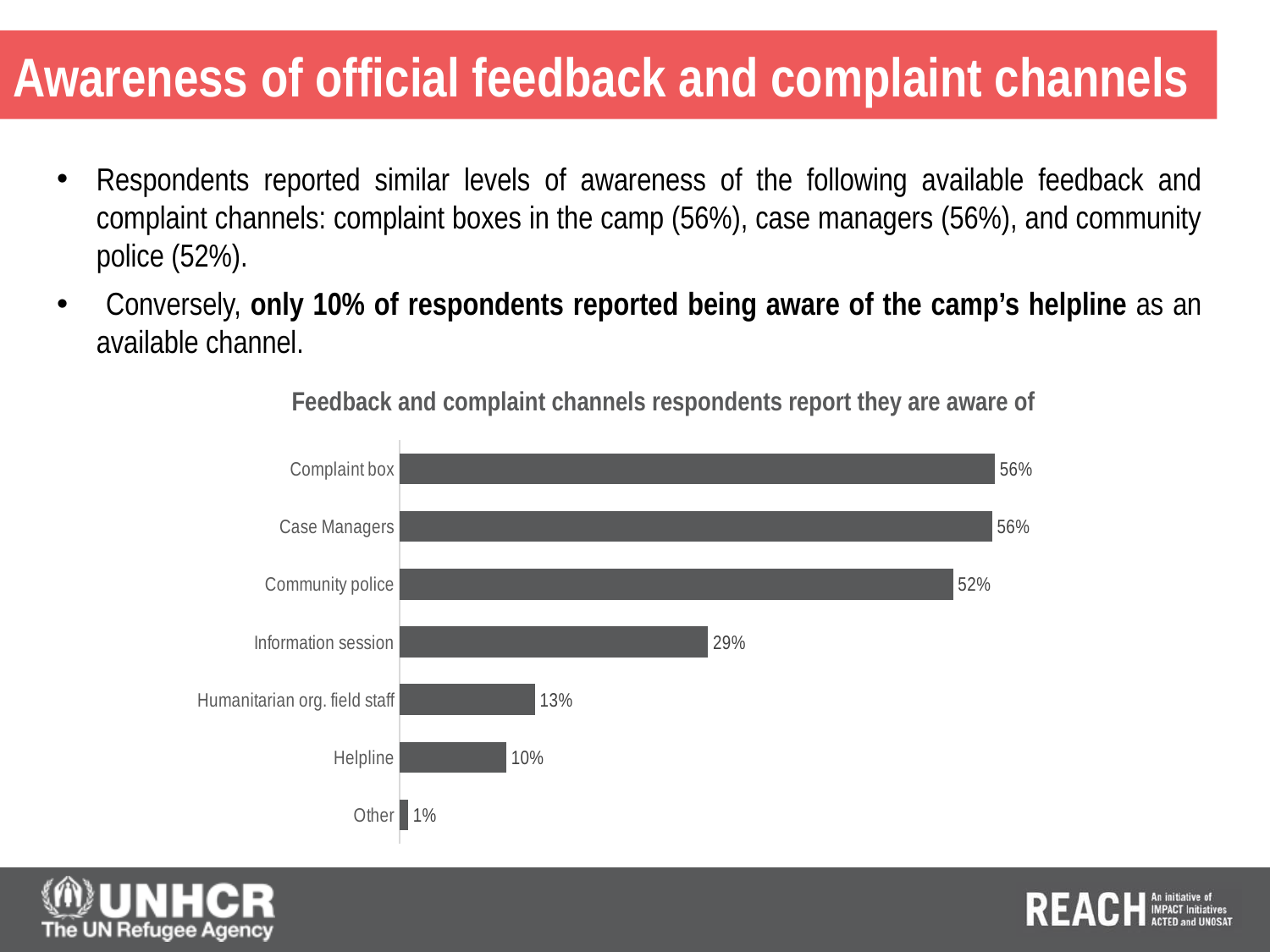
What is the difference between the values for Community police and Information session? 23% Which two categories share the highest value of 56%? Complaint box and Case Managers What percentage of respondents reported being aware of the Helpline? 10% What percentage is shown for Information session? 29% What kind of chart is shown on the slide? Bar chart What is the difference between the values for Complaint box and Helpline? 46% Which category has the lowest value in the chart? Other What is the value shown for Community police? 52% How many categories are shown in the chart? 7 What is the value for Humanitarian org. field staff? 13% What is the title of the chart? Feedback and complaint channels respondents report they are aware of Which is larger, the value for Information session or the value for Humanitarian org. field staff? Information session